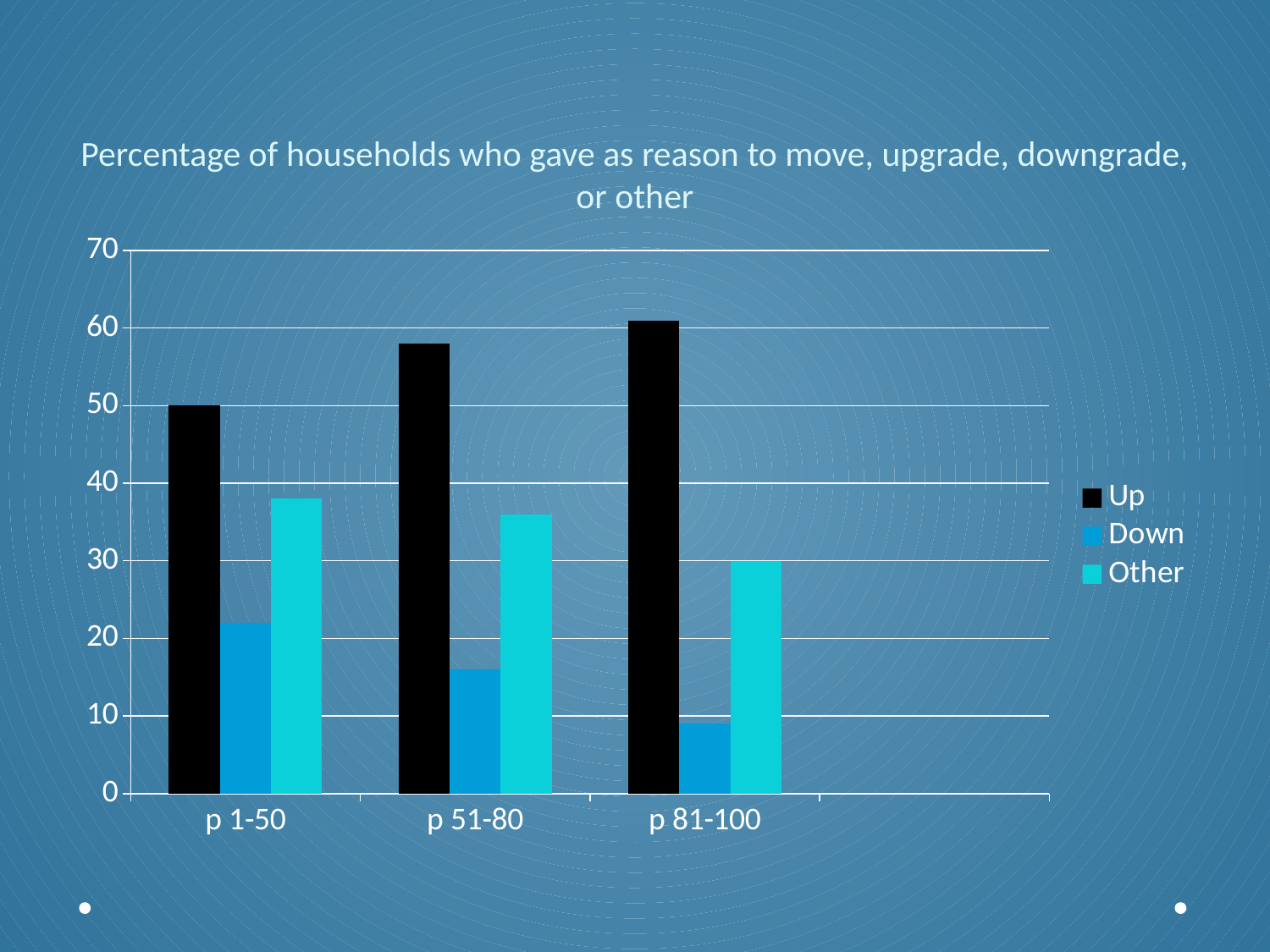
What is the value for Other in the p 81-100 category? 30 Which category has the highest value for Up? p 81-100 How many series does the legend list? 3 Do the values for Down rise or fall from p 1-50 to p 81-100? fall What is the value for Up in the p 1-50 category? 50 What is the title of the chart? Percentage of households who gave as reason to move, upgrade, downgrade, or other Is the value for Up in the p 51-80 category greater or less than 50? greater How many categories are shown on the x axis? 3 Which category has the lowest value for Down? p 81-100 Which is larger in the p 1-50 category, Down or Other? Other What kind of chart is shown on the slide? bar chart